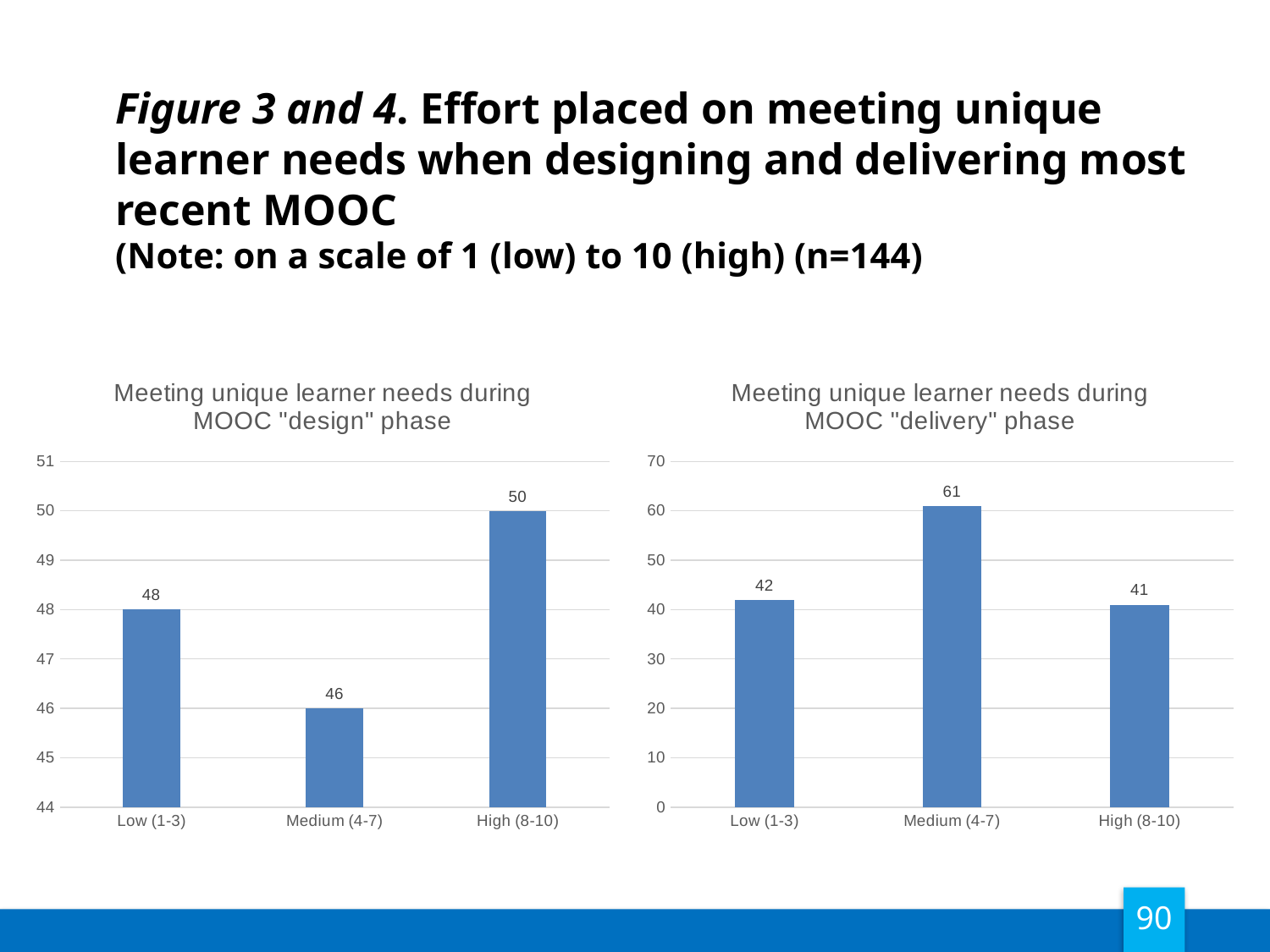
In the "delivery" phase chart, which is larger, Low (1-3) or Medium (4-7)? Medium (4-7) How many categories are shown in the "delivery" phase chart? 3 In the "design" phase chart, which category has the highest value? High (8-10) In the "delivery" phase chart, what is the difference between Medium (4-7) and Low (1-3)? 19 In the "design" phase chart, what is the value for Medium (4-7)? 46 In the "delivery" phase chart, which category has the lowest value? High (8-10) In the "delivery" phase chart, what is the value for Medium (4-7)? 61 What kind of chart is the "design" phase chart? bar chart In the "delivery" phase chart, what is the value for Low (1-3)? 42 In the "design" phase chart, is the value for Low (1-3) greater or less than 47? greater What is the title of the chart on the left? Meeting unique learner needs during MOOC "design" phase In the "design" phase chart, what is the difference between High (8-10) and Medium (4-7)? 4